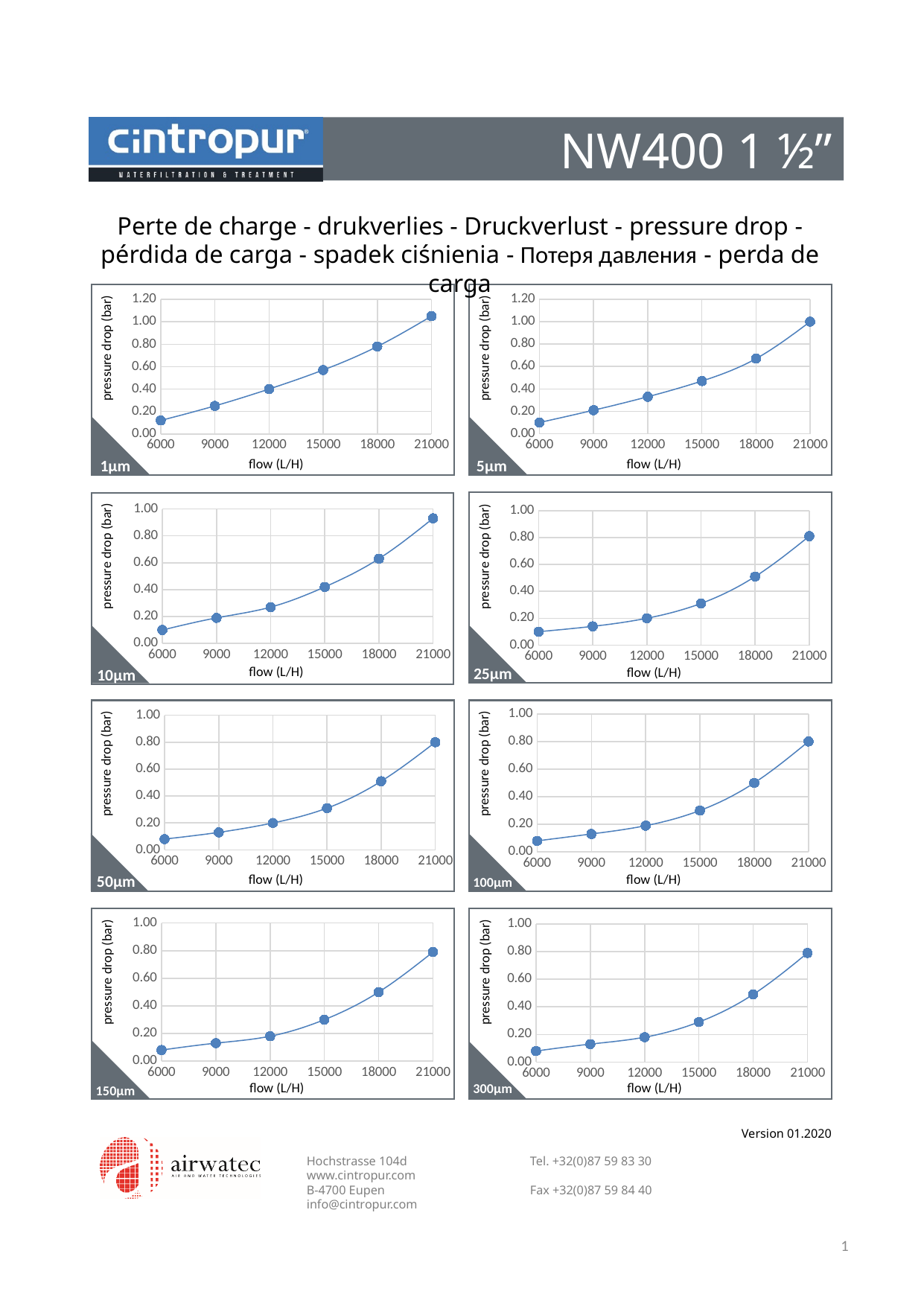
How many data points are plotted on the 5µm chart? 6 What is the x-axis label on the 100µm chart? flow (L/H) On the 25µm chart, is the pressure drop at 18000 L/H greater or less than 0.60 bar? less How many charts are shown on the slide? 8 On the 300µm chart, is the pressure drop at 6000 L/H greater or less than 0.20 bar? less On the 50µm chart, which flow rate has the highest pressure drop? 21000 What kind of chart is the 1µm chart? line chart On the 5µm chart, which is larger: the pressure drop at 12000 L/H or at 18000 L/H? 18000 L/H On the 1µm chart, does the pressure drop rise or fall as flow increases? rise On the 1µm chart, is the pressure drop at 21000 L/H greater or less than 1.00 bar? greater On the 150µm chart, which flow rate has the lowest pressure drop? 6000